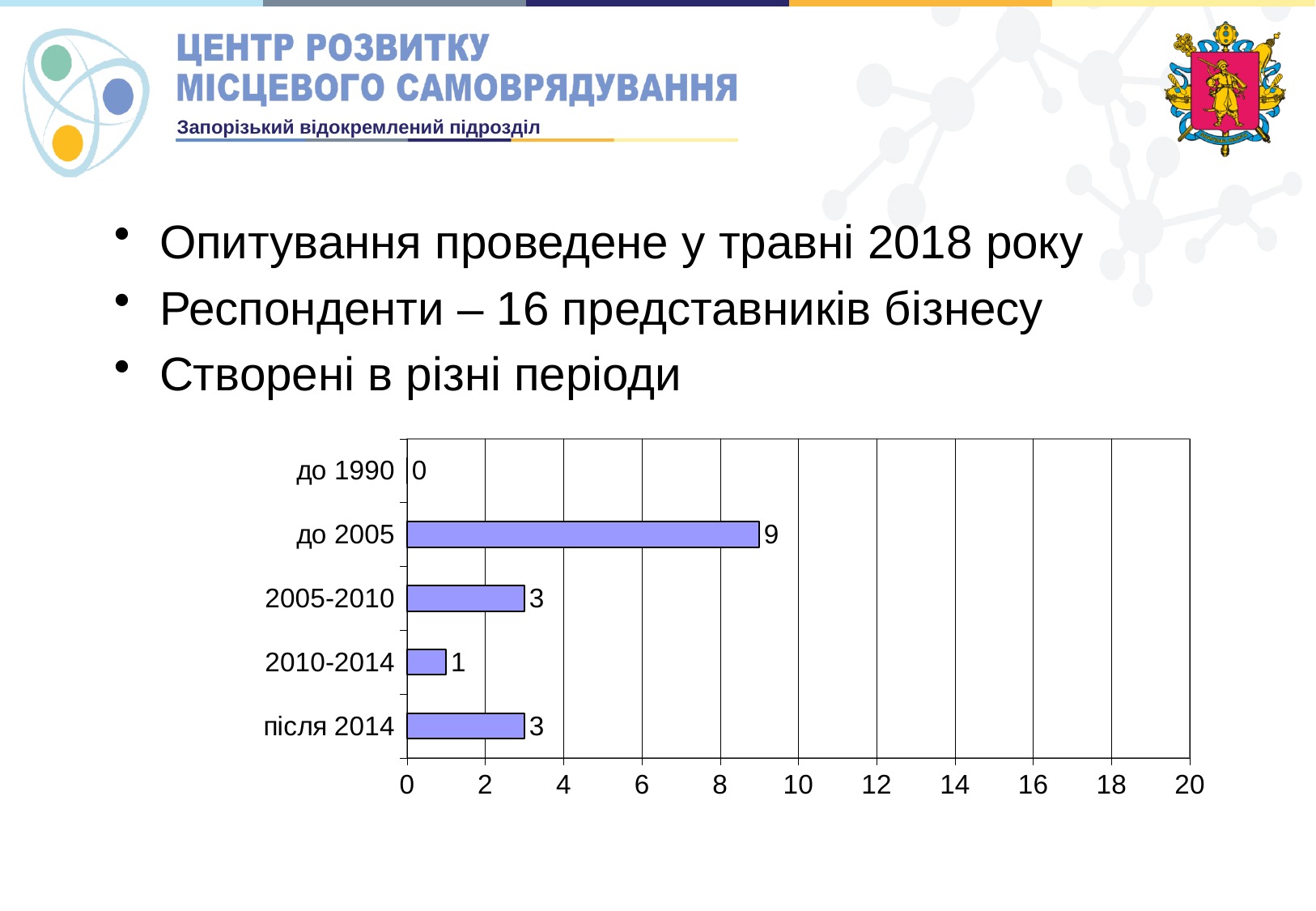
Which category has the highest value? до 2005 Is the value for "до 2005" greater or less than 10? less What is the value for the category "після 2014"? 3 What is the value for the category "до 1990"? 0 What is the value for the category "до 2005"? 9 Which category has the lowest value? до 1990 What kind of chart is shown on the slide? bar chart What is the value for the category "2010-2014"? 1 What is the maximum value shown on the horizontal axis? 20 How many categories are shown on the chart? 5 What is the difference between the values for "до 2005" and "2005-2010"? 6 Which is larger, the value for "2005-2010" or the value for "2010-2014"? 2005-2010